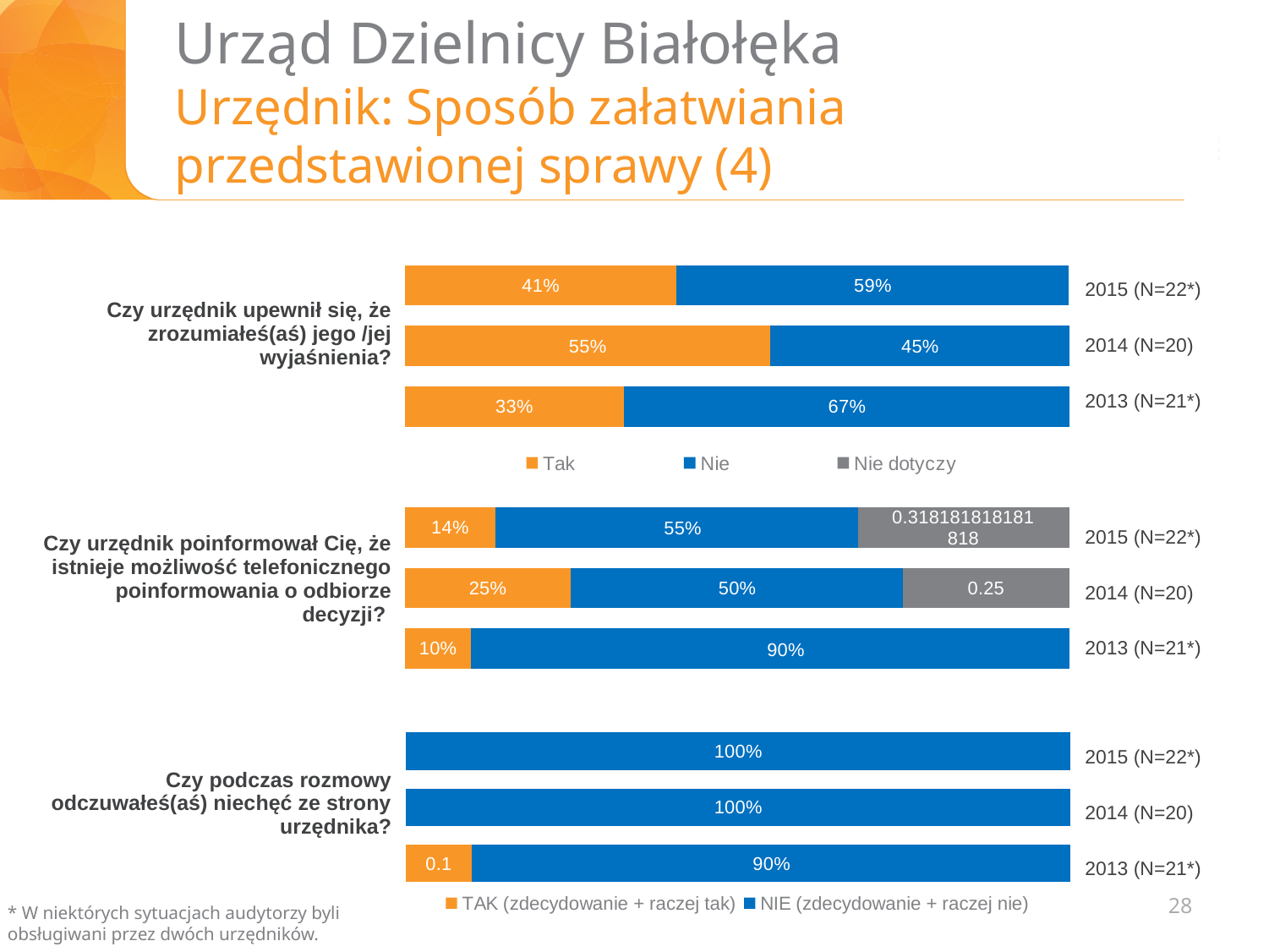
In the top chart, how many entries does the legend list? 3 In the middle chart, which year has the lowest Tak value? 2013 (N=21*) In the middle chart, what label is shown on the grey Nie dotyczy segment for 2014 (N=20)? 0.25 In the bottom chart ("Czy podczas rozmowy odczuwałeś(aś) niechęć ze strony urzędnika?"), what is the value for NIE in 2015 (N=22*)? 100% What type of chart is used on this slide? Stacked bar chart In the bottom chart, what label is shown on the orange TAK segment for 2013 (N=21*)? 0.1 In the top chart ("Czy urzędnik upewnił się, że zrozumiałeś(aś) jego /jej wyjaśnienia?"), what is the value for Tak in 2015 (N=22*)? 41% In the middle chart ("Czy urzędnik poinformował Cię, że istnieje możliwość telefonicznego poinformowania o odbiorze decyzji?"), what is the value for Nie in 2013 (N=21*)? 90% In the top chart, which year has the highest Tak value? 2014 (N=20) In the middle chart, what is the value for Tak in 2014 (N=20)? 25% In the top chart, what is the difference between the Nie value and the Tak value in 2015 (N=22*)? 18% In the top chart, what is the value for Nie in 2013 (N=21*)? 67%